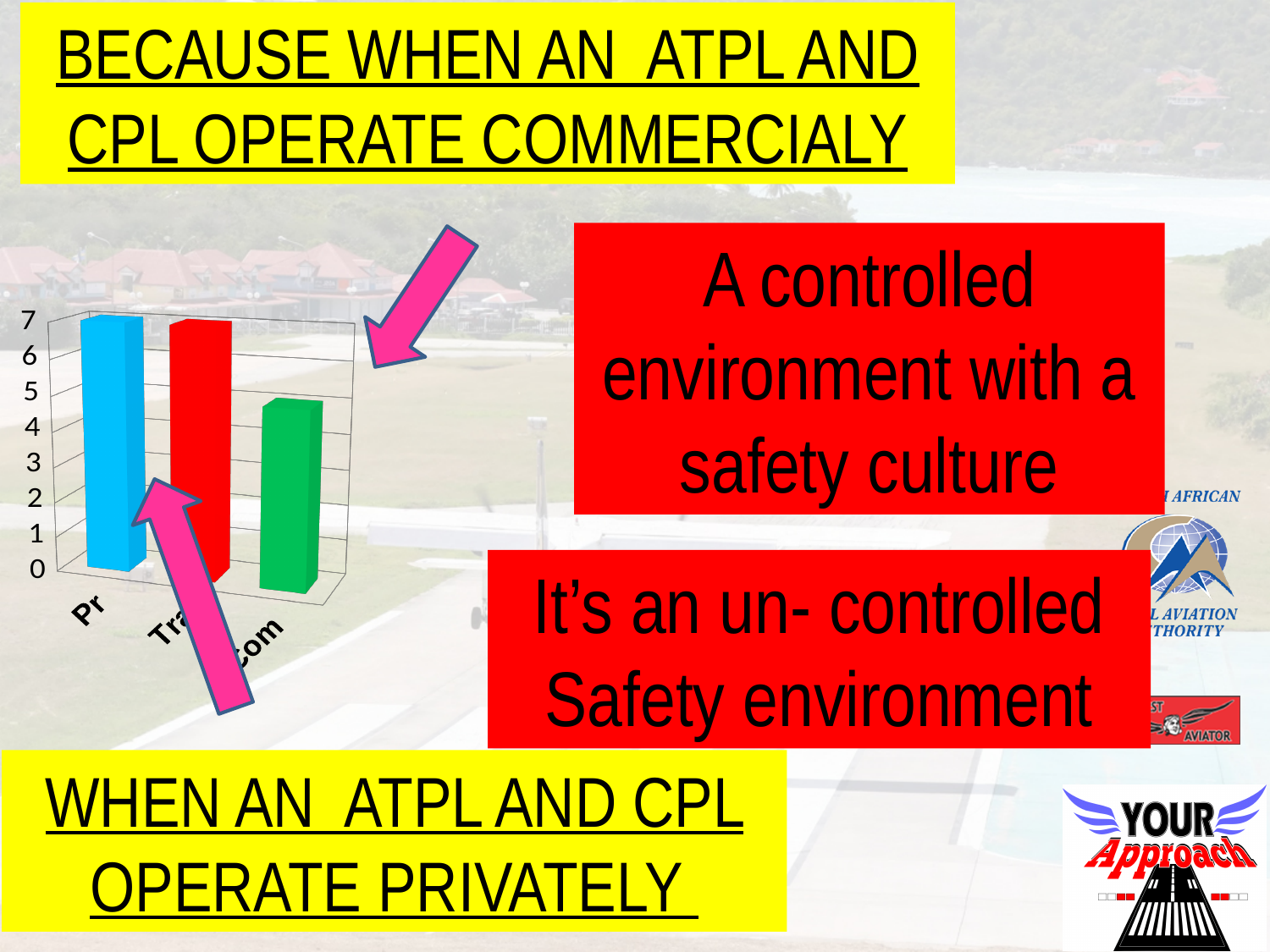
Which is larger, the red bar or the green bar? the red bar Which bar in the chart is the lowest? the green bar (third bar) What is the highest tick value shown on the vertical axis of the chart? 7 Which is larger, the blue bar or the green bar? the blue bar Is the value for Pr (the blue bar) greater or less than 3? greater Is the value of the green bar greater or less than 2? greater What colours are the three bars in the chart, from left to right? blue, red, green What kind of chart is shown on the slide? bar chart Is the value of the red bar greater or less than 4? greater How many bars are plotted in the chart? 3